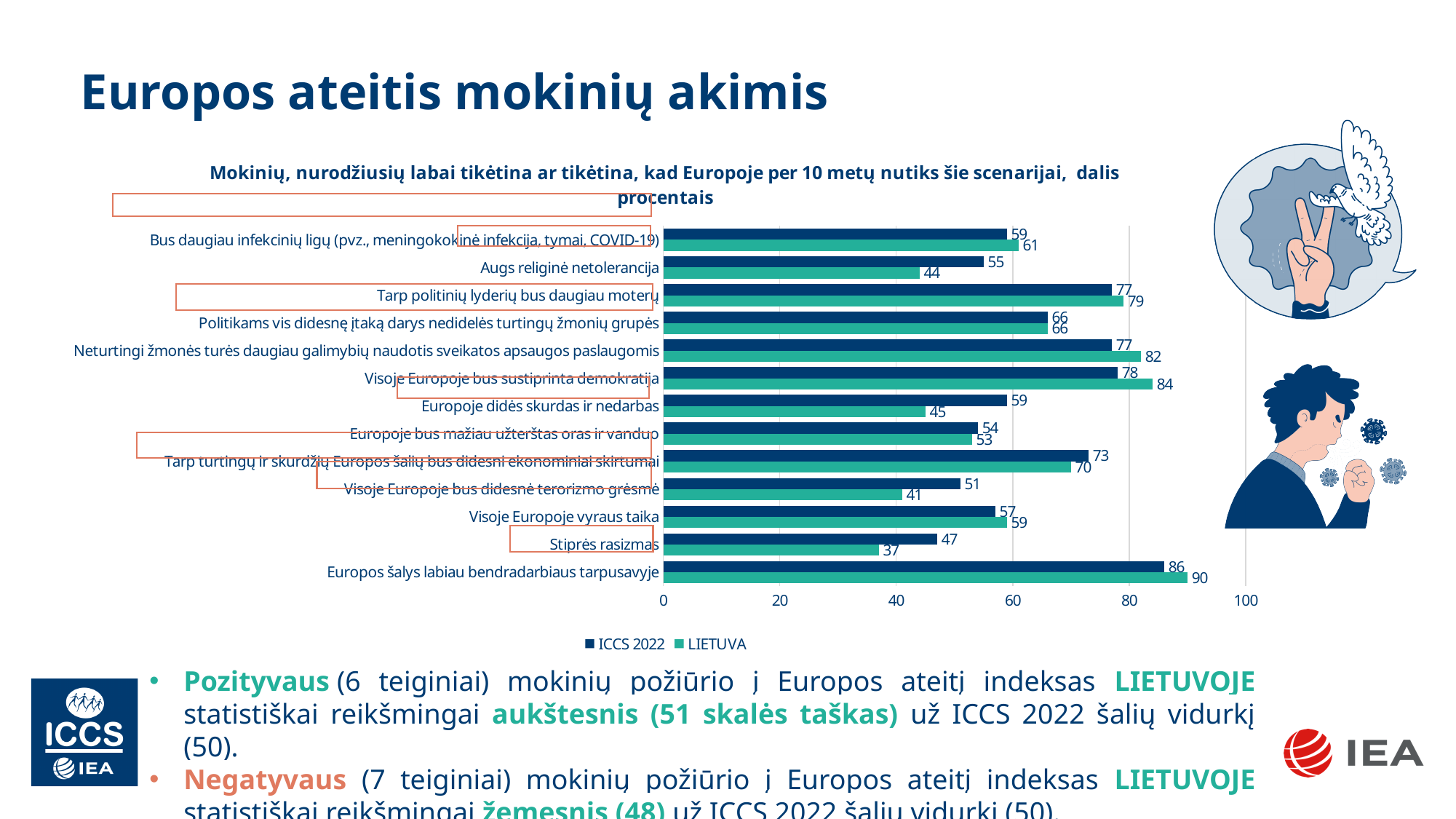
What type of chart is shown on the slide? Bar chart What is the LIETUVA value for "Europos šalys labiau bendradarbiaus tarpusavyje"? 90 What is the ICCS 2022 value for "Stiprės rasizmas"? 47 Which category has the lowest LIETUVA value? Stiprės rasizmas Which category has the highest LIETUVA value? Europos šalys labiau bendradarbiaus tarpusavyje For "Visoje Europoje bus sustiprinta demokratija", which series has the larger value, ICCS 2022 or LIETUVA? LIETUVA How many categories are shown in the chart? 13 How many series does the legend list? 2 What is the LIETUVA value for "Augs religinė netolerancija"? 44 What is the difference between the LIETUVA and ICCS 2022 values for "Europoje didės skurdas ir nedarbas"? 14 For "Visoje Europoje bus didesnė terorizmo grėsmė", which series has the larger value, ICCS 2022 or LIETUVA? ICCS 2022 Which series is shown in teal (green) in the chart? LIETUVA